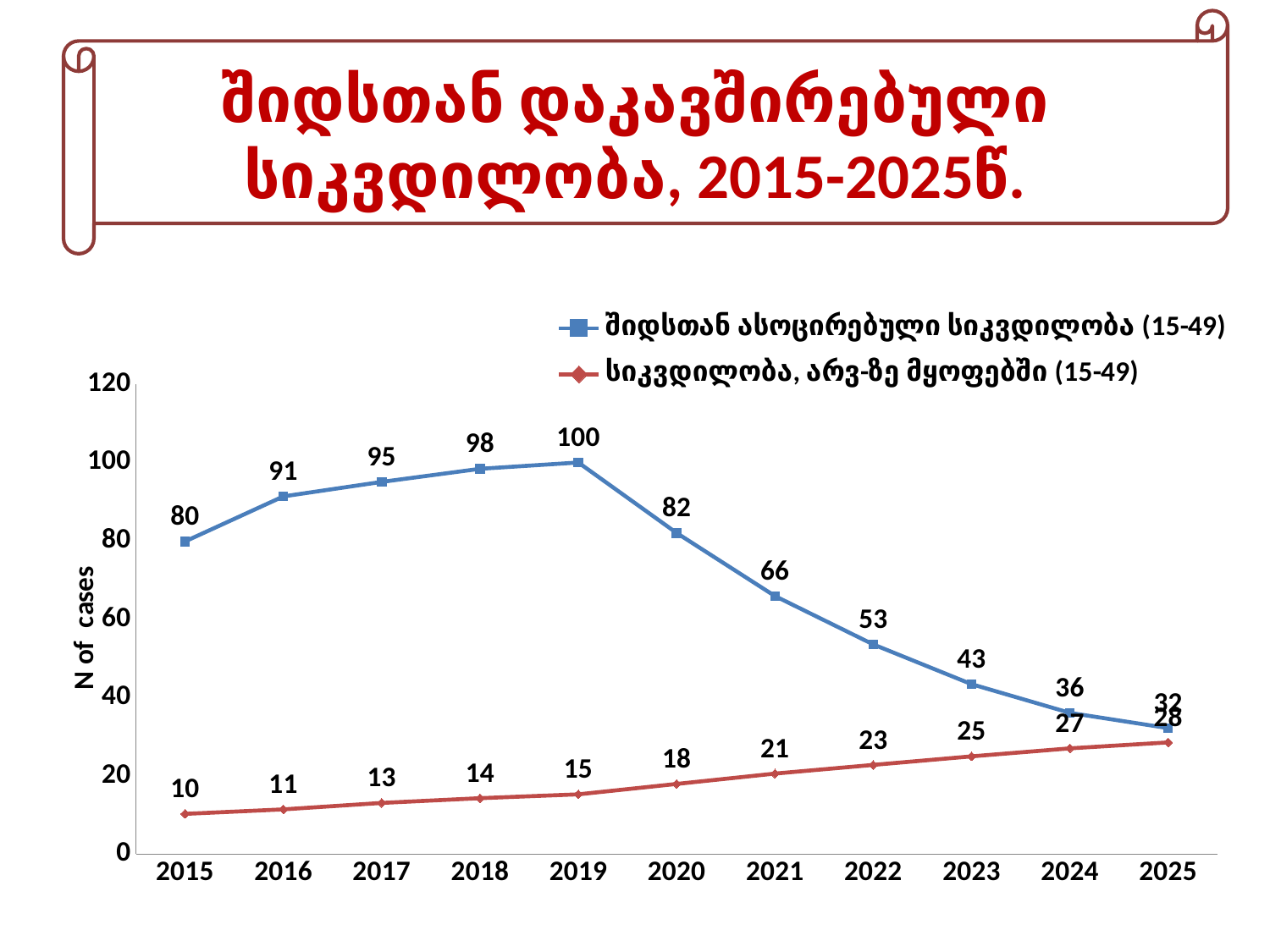
What is the label of the y axis? N of cases What is the value of the red series (სიკვდილობა, არვ-ზე მყოფებში (15-49)) in 2022? 23 What type of chart is shown on the slide? line chart Which series has the larger value in 2025, the blue series or the red series? the blue series (შიდსთან ასოცირებული სიკვდილობა (15-49)) In which year is the red series (სიკვდილობა, არვ-ზე მყოფებში (15-49)) at its lowest value? 2015 How many years are plotted along the x axis? 11 Does the red series (სიკვდილობა, არვ-ზე მყოფებში (15-49)) rise or fall from 2015 to 2025? rise How many series does the legend list? 2 In which year does the blue series (შიდსთან ასოცირებული სიკვდილობა (15-49)) reach its highest value? 2019 Does the blue series (შიდსთან ასოცირებული სიკვდილობა (15-49)) rise or fall from 2019 to 2025? fall What is the value of the blue series (შიდსთან ასოცირებული სიკვდილობა (15-49)) in 2019? 100 What is the difference between the blue series and the red series in 2020? 64